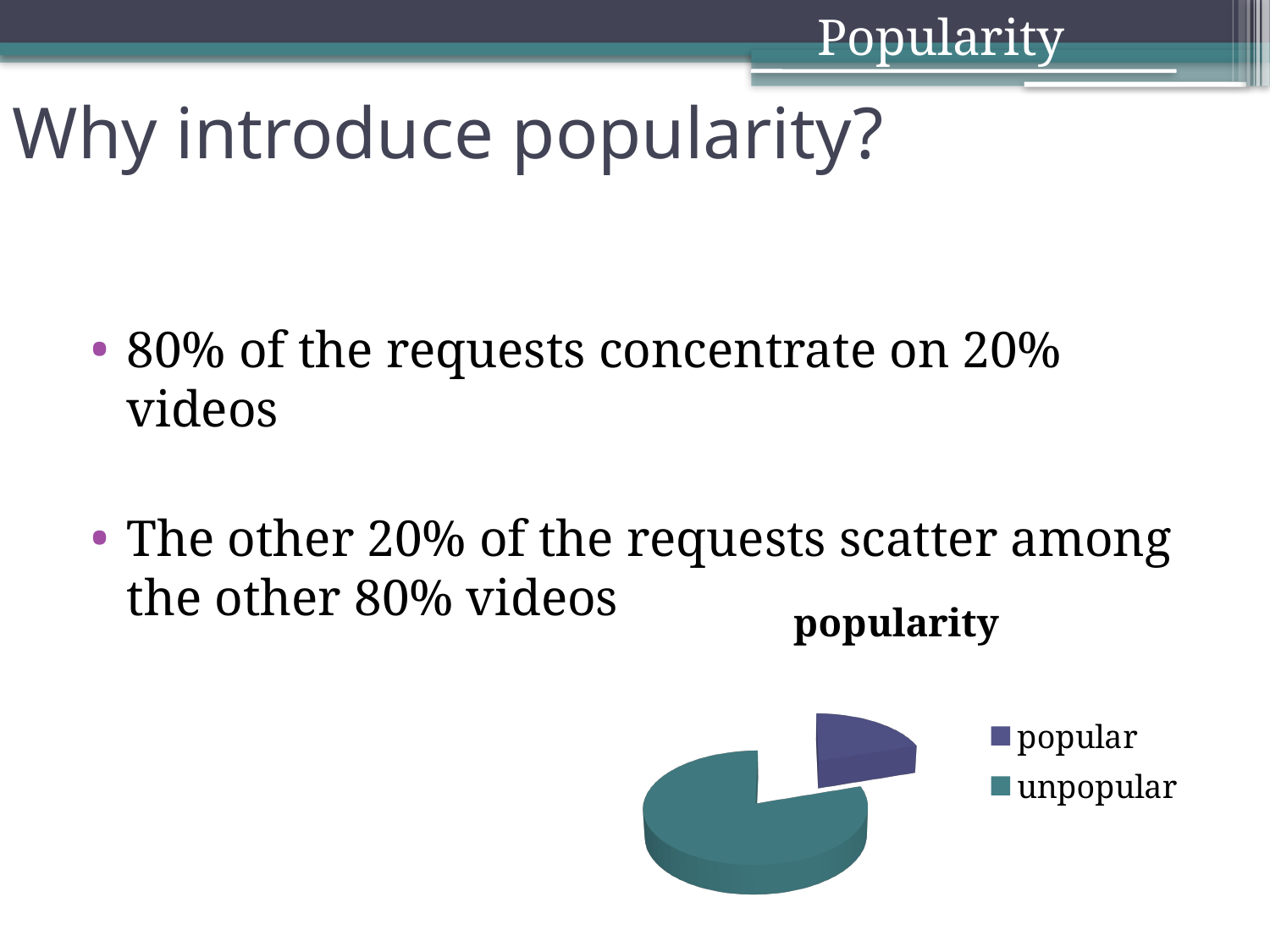
What kind of chart is shown on the slide? pie chart What colour is the slice for unpopular? teal How many slices does the pie chart have? 2 Which category has the largest slice of the pie? unpopular How many entries does the chart's legend list? 2 Which slice is larger, popular or unpopular? unpopular What is the title of the chart? popularity Which category has the smallest slice of the pie? popular